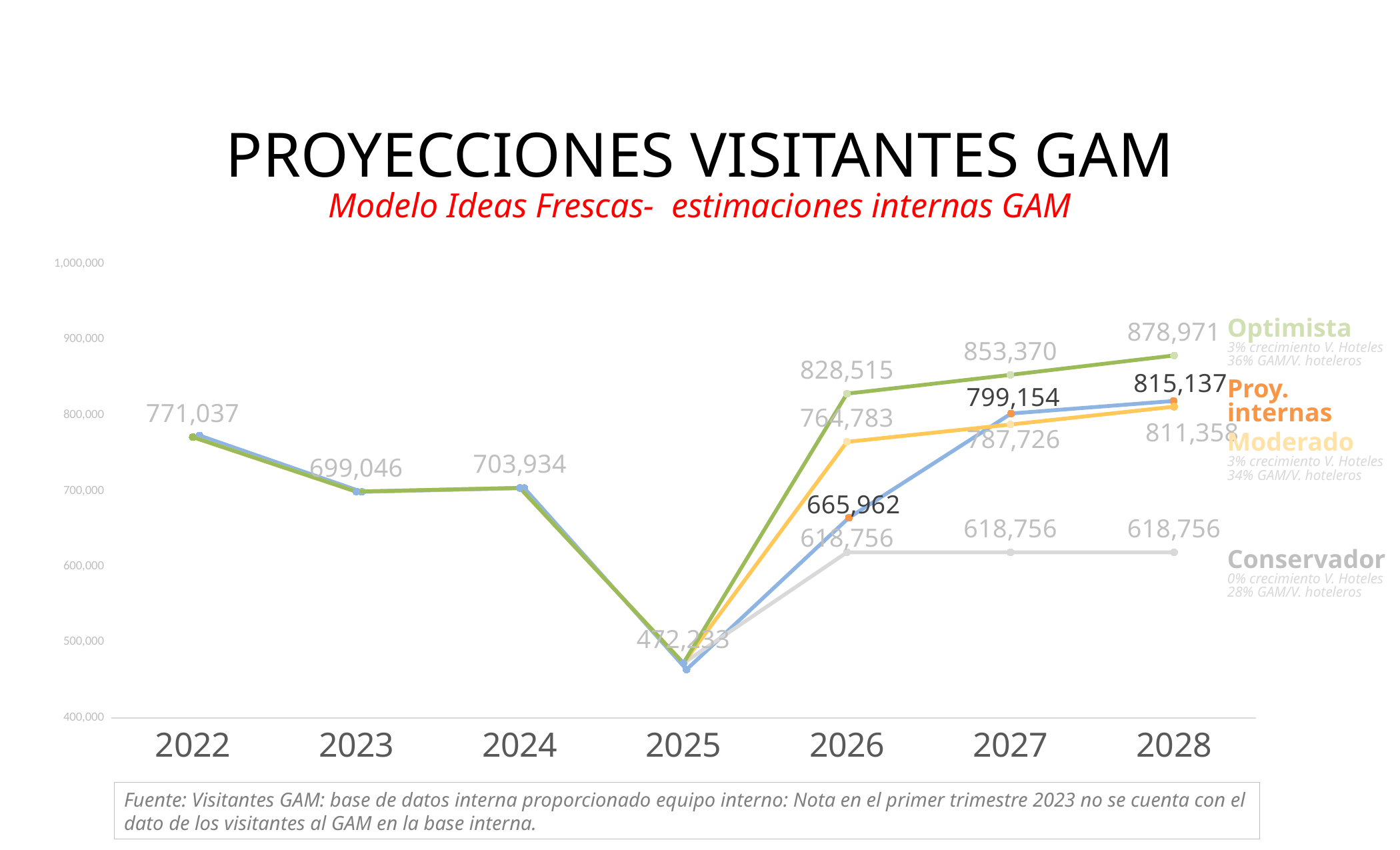
Which scenario has the highest value in 2028? Optimista What kind of chart is shown on the slide? line chart Does the value fall or rise from 2024 to 2025? fall What is the Optimista value for 2028? 878,971 What is the value shown for 2025? 472,233 What is the Moderado value for 2026? 764,783 How many years are shown on the x axis? 7 Which is larger in 2027, the Proy. internas value or the Moderado value? Proy. internas What is the Proy. internas value for 2027? 799,154 What is the difference between the Optimista and Conservador values in 2026? 209,759 Which year has the lowest value on the chart? 2025 What is the Conservador value for 2027? 618,756